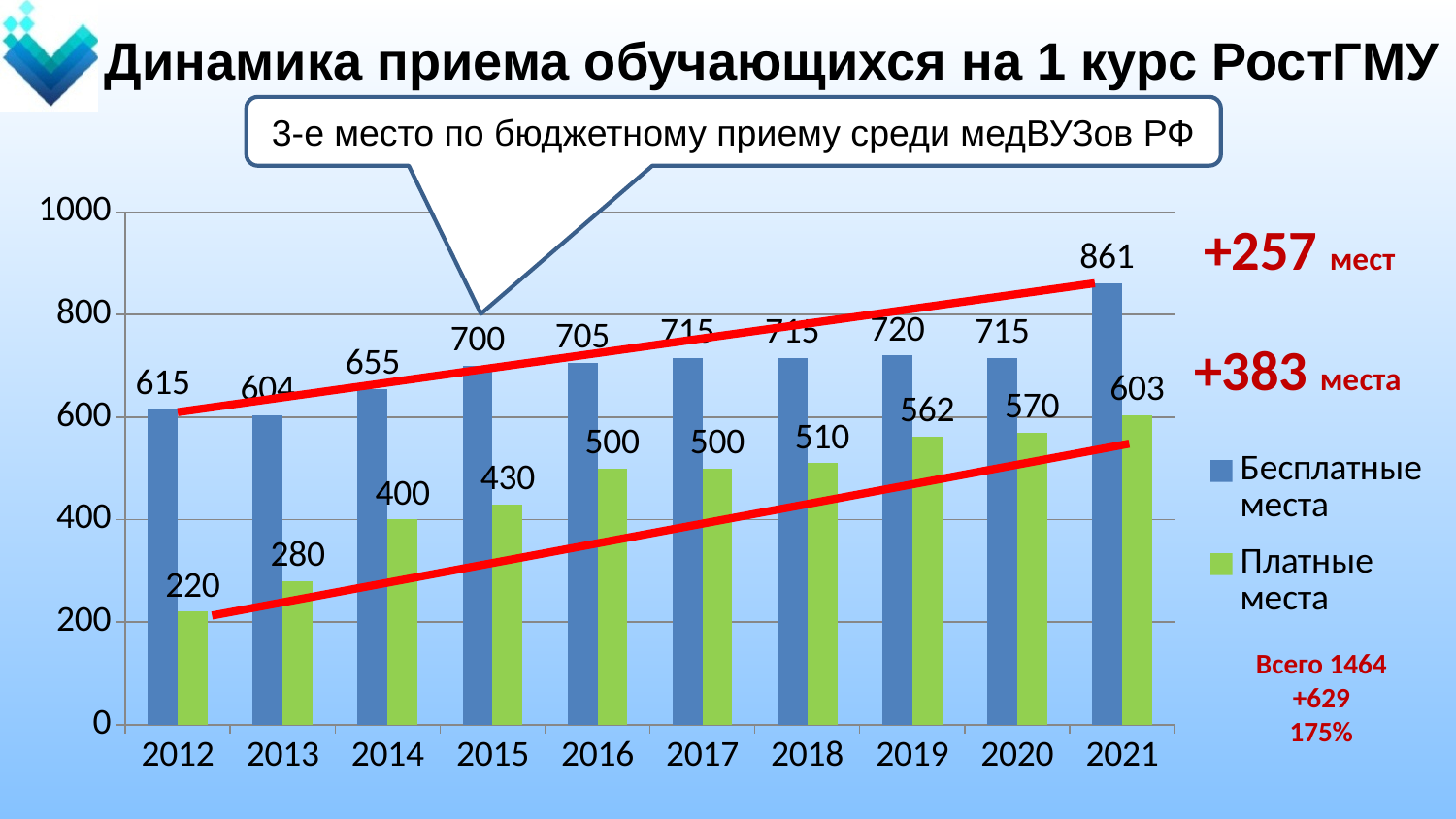
Which year has the lowest value for Платные места? 2012 Which year has the highest value for Бесплатные места? 2021 What kind of chart is shown on the slide? bar chart What is the value for Платные места in 2012? 220 How many years are shown on the x axis? 10 Do the values for Платные места generally rise or fall from 2012 to 2021? rise How many series does the legend list? 2 What is the difference between Бесплатные места and Платные места in 2021? 258 Which is larger in 2014: Бесплатные места or Платные места? Бесплатные места What is the value for Платные места in 2019? 562 What is the value for Бесплатные места in 2021? 861 Is the value for Платные места in 2015 greater or less than 400? greater